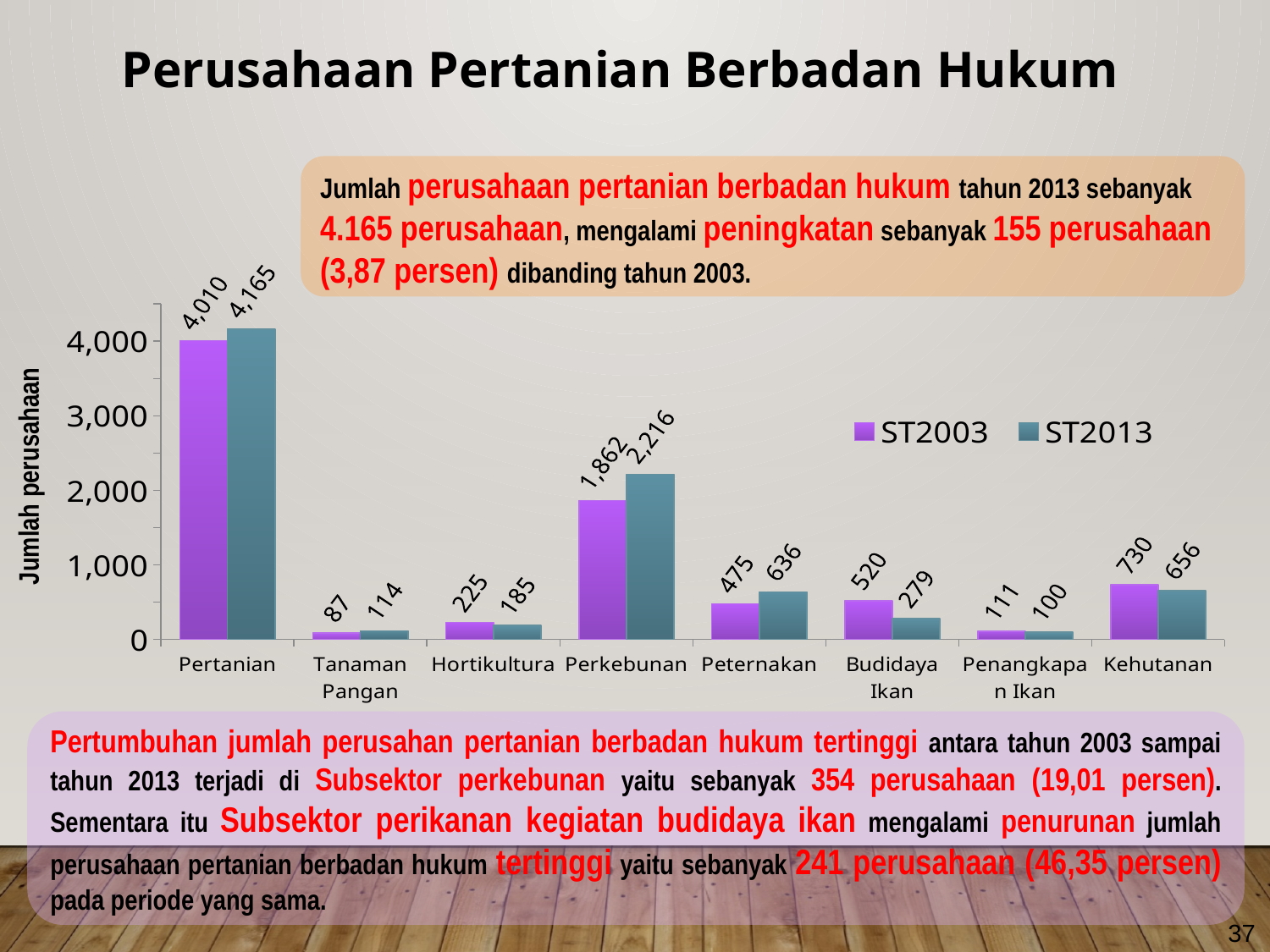
What is the difference between the ST2013 and ST2003 values for Perkebunan? 354 What is the ST2003 value for Budidaya Ikan? 520 Which is larger for Hortikultura, the ST2003 value or the ST2013 value? ST2003 What is the difference between the ST2003 and ST2013 values for Budidaya Ikan? 241 How many series does the legend list? 2 Is the ST2013 value for Peternakan greater or less than 1,000? less How many categories are shown on the x axis? 8 What kind of chart is shown on the slide? bar chart Which category has the lowest ST2003 value? Tanaman Pangan What is the ST2013 value for Perkebunan? 2,216 What is the ST2013 value for Kehutanan? 656 Which category has the highest ST2013 value? Pertanian